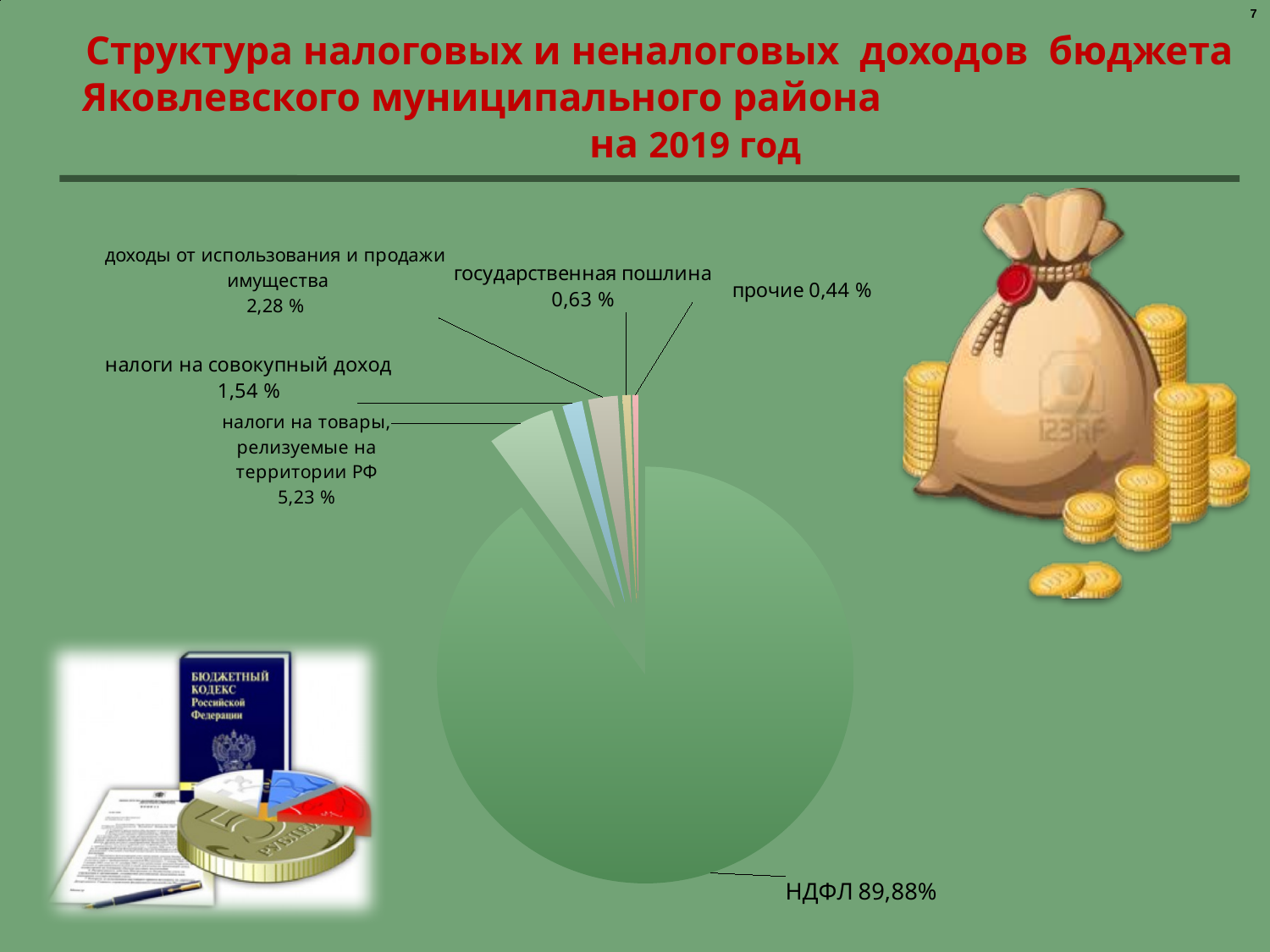
What kind of chart is shown on the slide? pie chart Which category has the largest slice of the pie? НДФЛ Which is larger: налоги на совокупный доход or государственная пошлина? налоги на совокупный доход Which category has the smallest slice of the pie? прочие What share of the pie does НДФЛ account for? 89,88% What is the value shown for налоги на товары, релизуемые на территории РФ? 5,23 % What is the value shown for государственная пошлина? 0,63 % What is the value shown for прочие? 0,44 % What is the difference between the shares of налоги на товары, релизуемые на территории РФ and доходы от использования и продажи имущества? 2,95 % What is the value shown for налоги на совокупный доход? 1,54 % How many slices does the pie chart have? 6 What is the value shown for доходы от использования и продажи имущества? 2,28 %